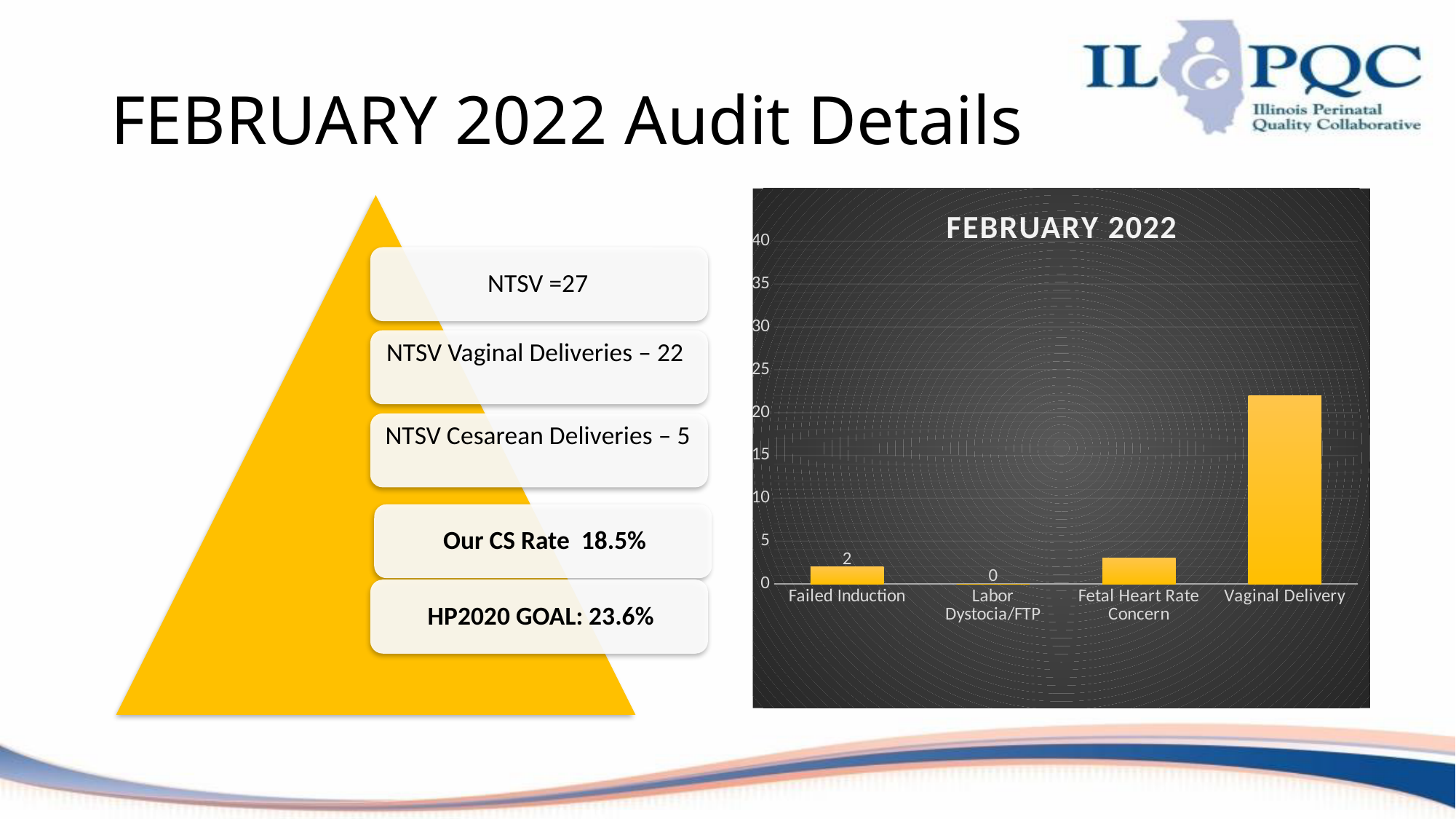
What type of chart is shown on the slide? bar chart What is the title of the chart? FEBRUARY 2022 Which is larger, the value for Vaginal Delivery or the value for Fetal Heart Rate Concern? Vaginal Delivery Which is larger, the value for Failed Induction or the value for Labor Dystocia/FTP? Failed Induction What is the difference between the values for Failed Induction and Labor Dystocia/FTP? 2 Is the value for Fetal Heart Rate Concern greater or less than 5? less What is the value for Labor Dystocia/FTP? 0 How many categories are shown on the x axis of the chart? 4 Which category has the highest value? Vaginal Delivery What is the value for Failed Induction? 2 Is the value for Vaginal Delivery greater or less than 15? greater Which category has the lowest value? Labor Dystocia/FTP